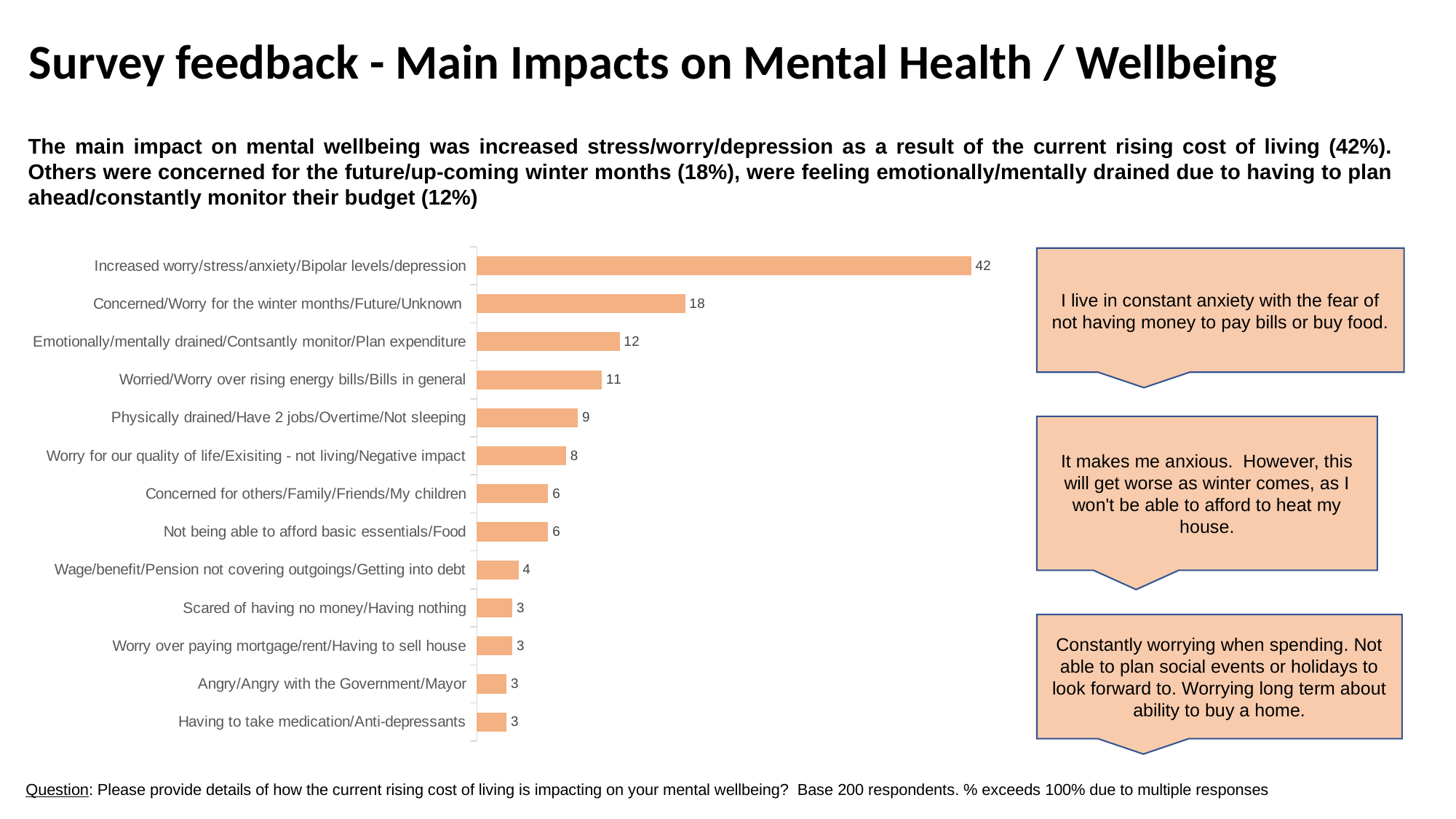
What kind of chart is shown on the slide? Bar chart Which category has the highest value? Increased worry/stress/anxiety/Bipolar levels/depression What is the value for "Wage/benefit/Pension not covering outgoings/Getting into debt"? 4 What is the difference between the values for "Emotionally/mentally drained/Contsantly monitor/Plan expenditure" and "Physically drained/Have 2 jobs/Overtime/Not sleeping"? 3 What is the value for "Worried/Worry over rising energy bills/Bills in general"? 11 What is the value for "Increased worry/stress/anxiety/Bipolar levels/depression"? 42 What is the difference between the values for "Increased worry/stress/anxiety/Bipolar levels/depression" and "Concerned/Worry for the winter months/Future/Unknown"? 24 Which is larger: the value for "Worry for our quality of life/Exisiting - not living/Negative impact" or the value for "Concerned for others/Family/Friends/My children"? Worry for our quality of life/Exisiting - not living/Negative impact How many categories have a value of 3? 4 What is the value for "Concerned/Worry for the winter months/Future/Unknown"? 18 What is the value for "Not being able to afford basic essentials/Food"? 6 How many categories are shown in the chart? 13